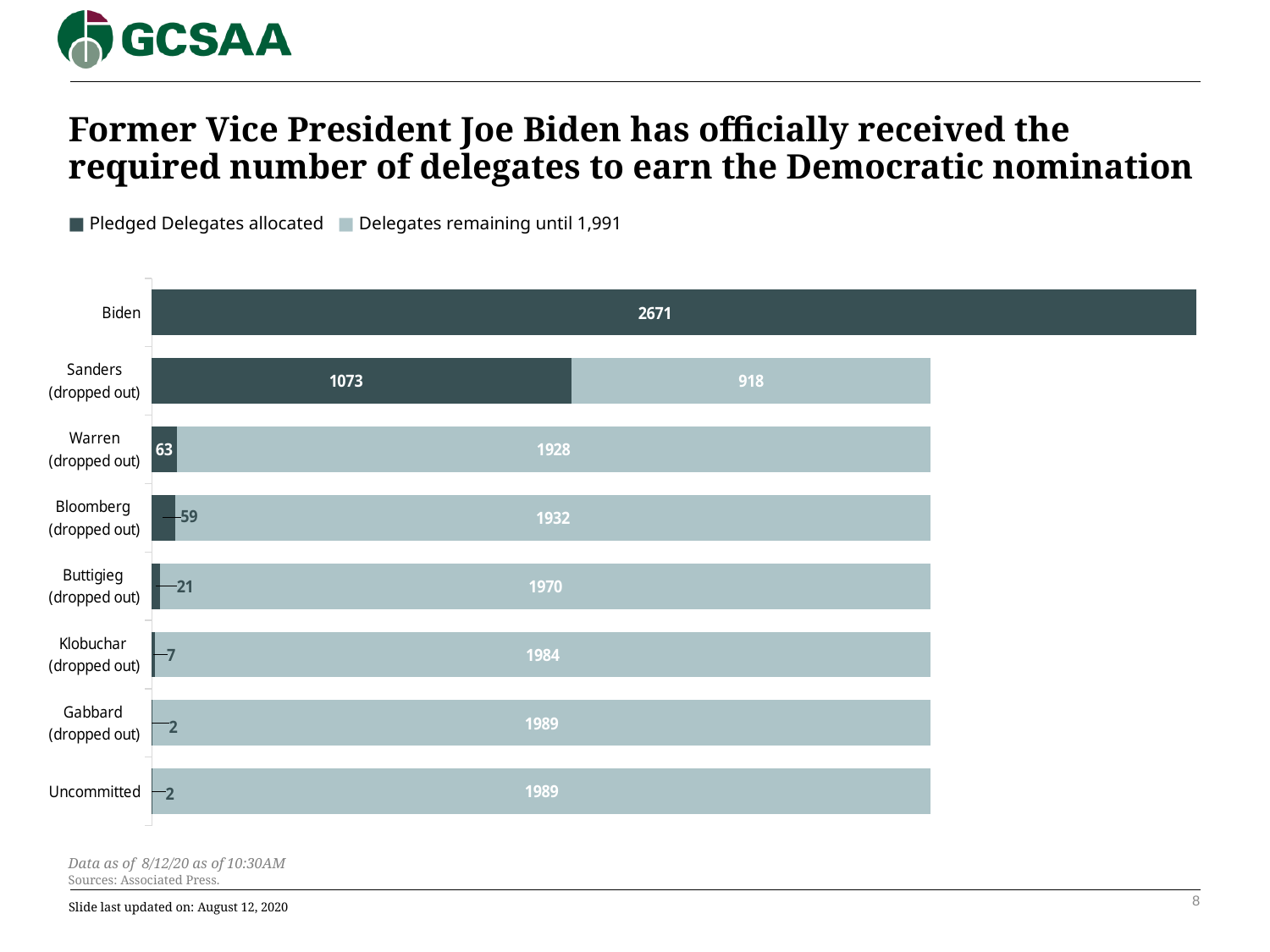
What is the second legend entry on the chart? Delegates remaining until 1,991 How many delegates remain until 1,991 for Warren? 1928 How many pledged delegates were allocated to Sanders? 1073 Which candidate has the highest number of pledged delegates allocated? Biden What kind of chart is shown on the slide? Stacked bar chart Who has more pledged delegates allocated, Buttigieg or Klobuchar? Buttigieg What is the difference in pledged delegates allocated between Sanders and Warren? 1010 What is the total of the stacked bar for Sanders? 1991 How many series does the legend list? 2 How many categories are shown on the chart? 8 How many pledged delegates were allocated to Bloomberg? 59 How many pledged delegates were allocated to Biden? 2671